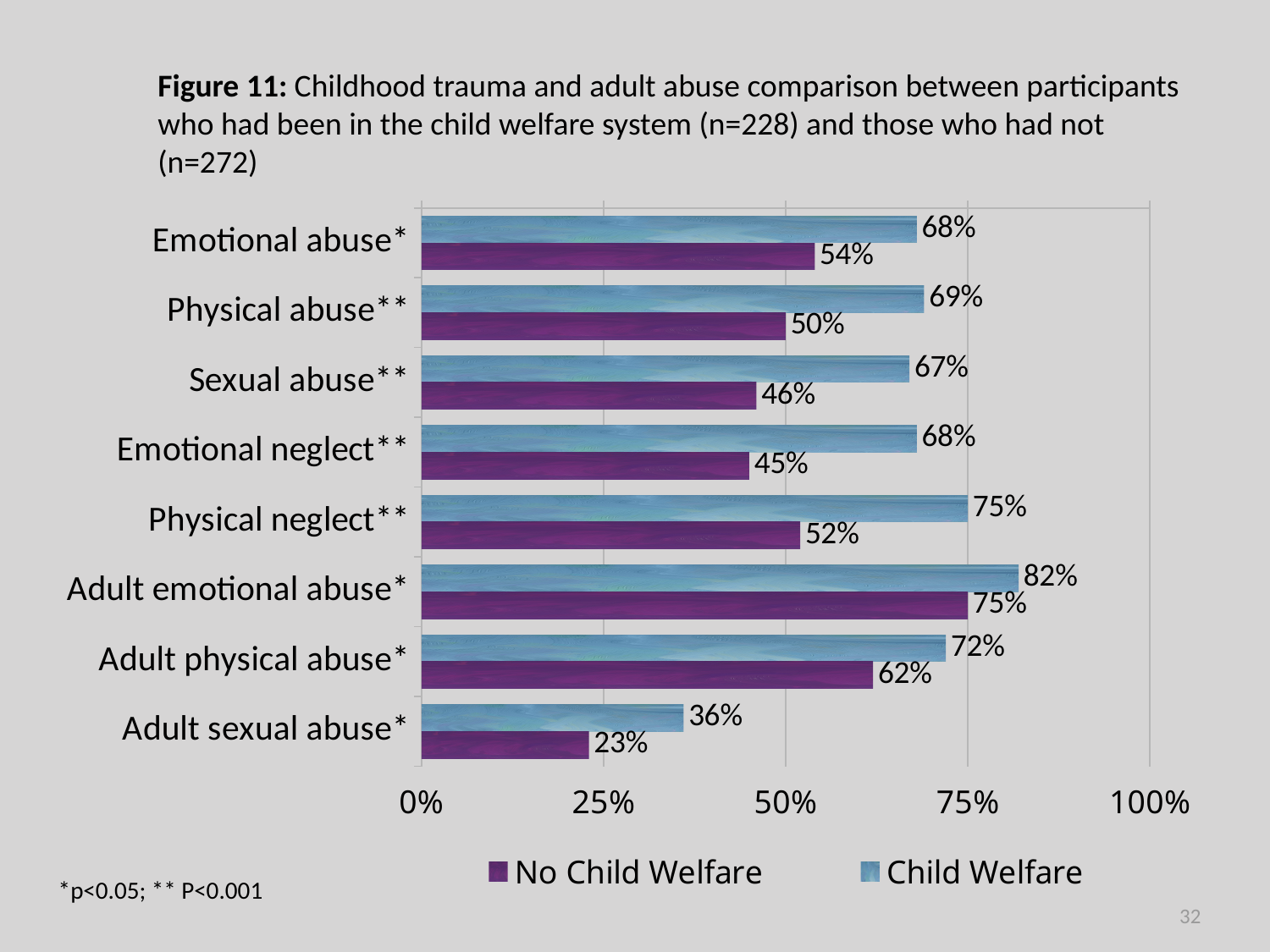
How many categories are shown on the chart? 8 What is the difference between the Child Welfare and No Child Welfare values for Adult physical abuse*? 10% What is the difference between the Child Welfare and No Child Welfare values for Emotional neglect**? 23% What kind of chart is shown on the slide? Bar chart Which category has the highest Child Welfare value? Adult emotional abuse* What is the No Child Welfare value for Sexual abuse**? 46% Which series is shown in purple? No Child Welfare What is the Child Welfare value for Physical neglect**? 75% Which category has the lowest No Child Welfare value? Adult sexual abuse* What is the No Child Welfare value for Adult sexual abuse*? 23% Which is larger: the Child Welfare value for Physical abuse** or the Child Welfare value for Emotional abuse*? Physical abuse** How many series does the legend list? 2